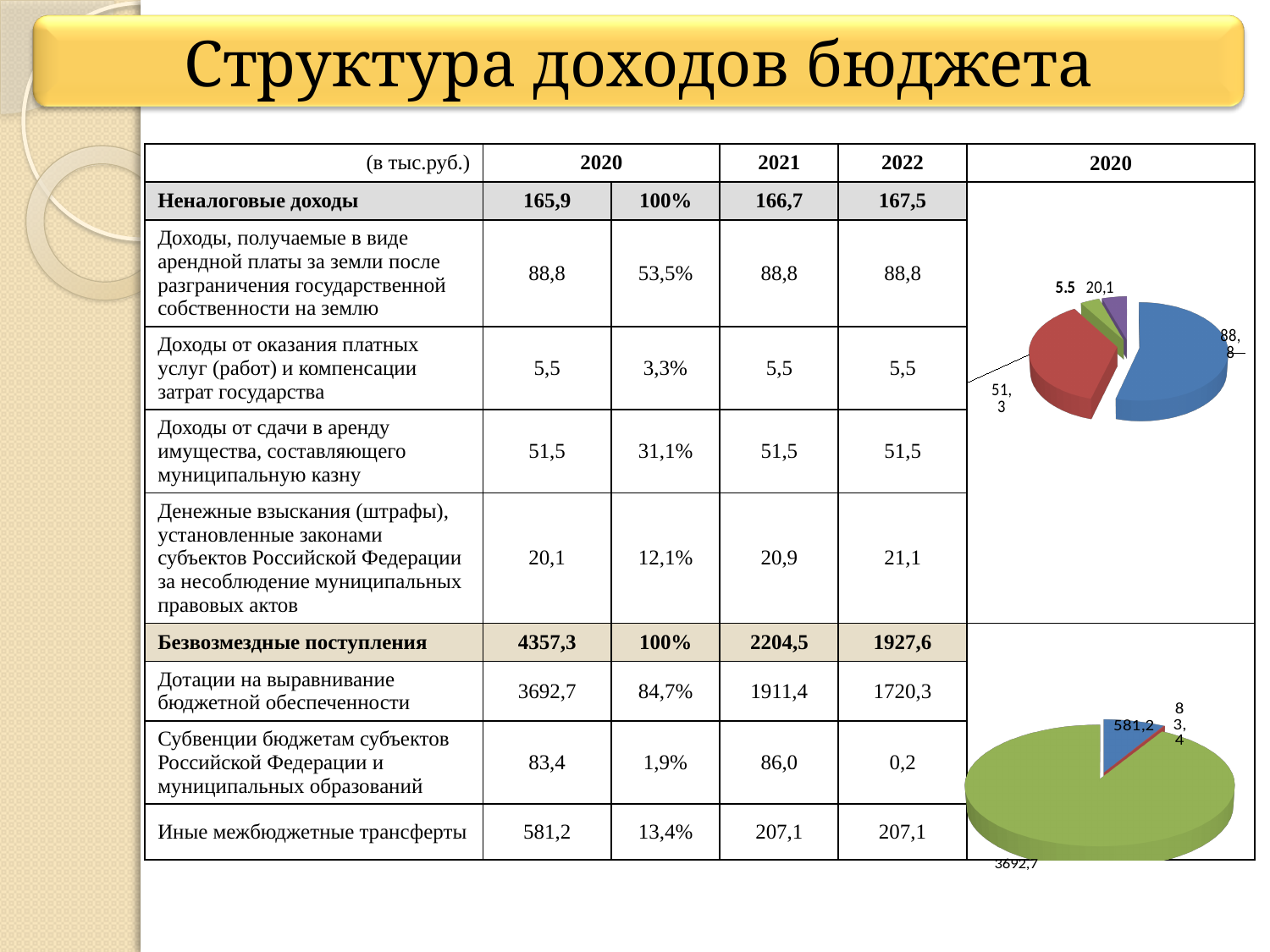
In the bottom pie chart, what is the difference between the slice labelled 3692,7 and the slice labelled 581,2? 3111,5 In the top pie chart, what is the difference between the slice labelled 88,8 and the slice labelled 20,1? 68,7 How many slices does the top pie chart have? 4 In the bottom pie chart, what is the value of the largest slice? 3692,7 What type of chart is the bottom chart on the right side of the slide? pie chart In the bottom pie chart, which is larger: the slice labelled 581,2 or the slice labelled 83,4? 581,2 In the top pie chart, what is the value of the smallest slice? 5.5 How many slices does the bottom pie chart have? 3 What type of chart is the top chart on the right side of the slide? pie chart What colour is the largest slice in the bottom pie chart? green In the top pie chart, what is the value of the largest slice? 88,8 In the bottom pie chart, what is the value of the smallest slice? 83,4